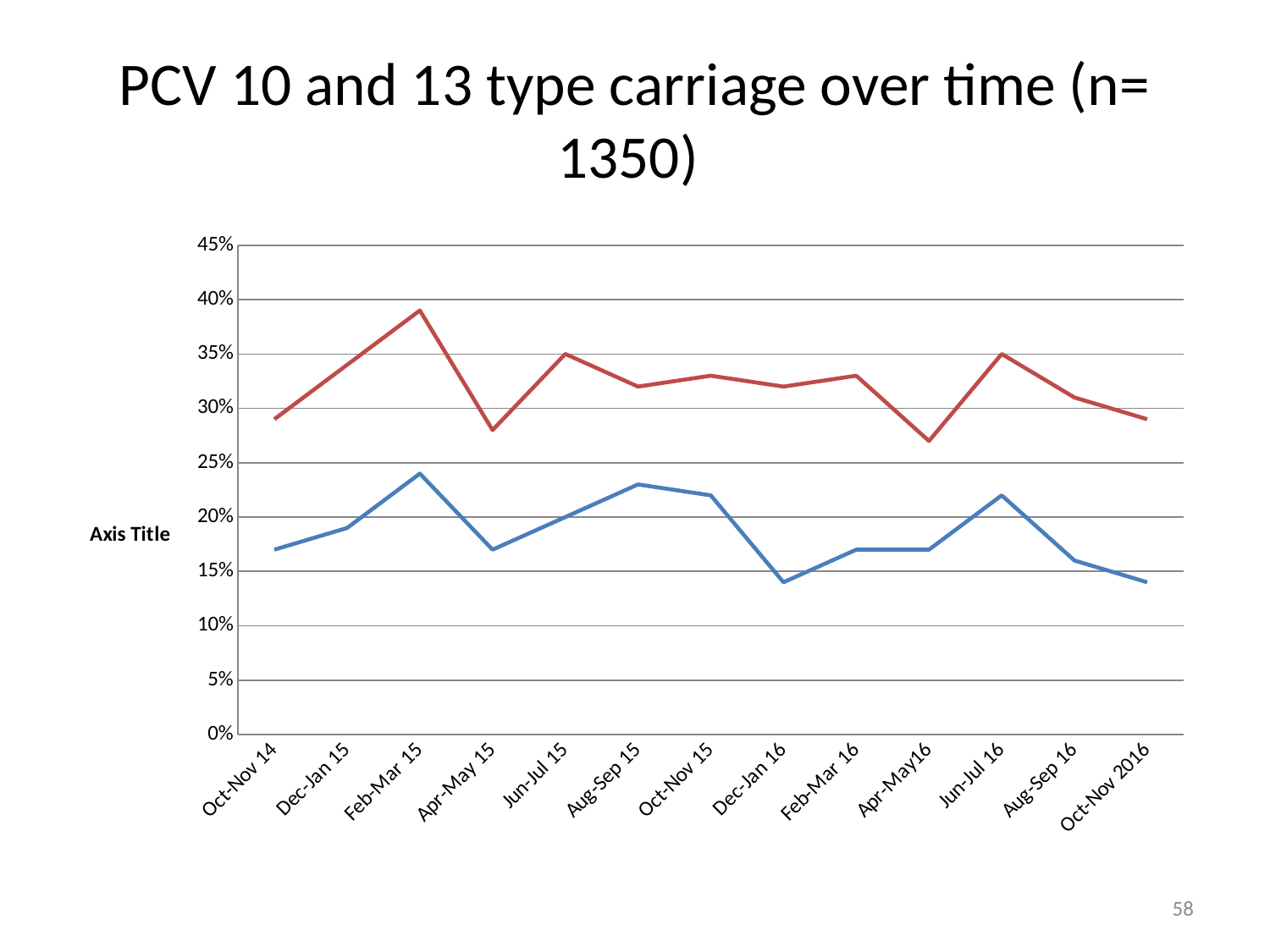
Which line has the higher value at Jun-Jul 16, the red line or the blue line? the red line For the blue line, which is larger: the value at Feb-Mar 15 or the value at Dec-Jan 16? Feb-Mar 15 How many time periods are shown along the x axis? 13 Is the value of the red line at Apr-May16 greater or less than 30%? less Is the value of the red line at Feb-Mar 15 greater or less than 35%? greater In which period does the red line reach its highest value? Feb-Mar 15 How many lines are plotted on the chart? 2 Is the value of the blue line at Feb-Mar 15 greater or less than 20%? greater What is the label shown on the vertical axis? Axis Title Does the blue line rise or fall from Jun-Jul 16 to Oct-Nov 2016? fall What kind of chart is shown on the slide? line chart